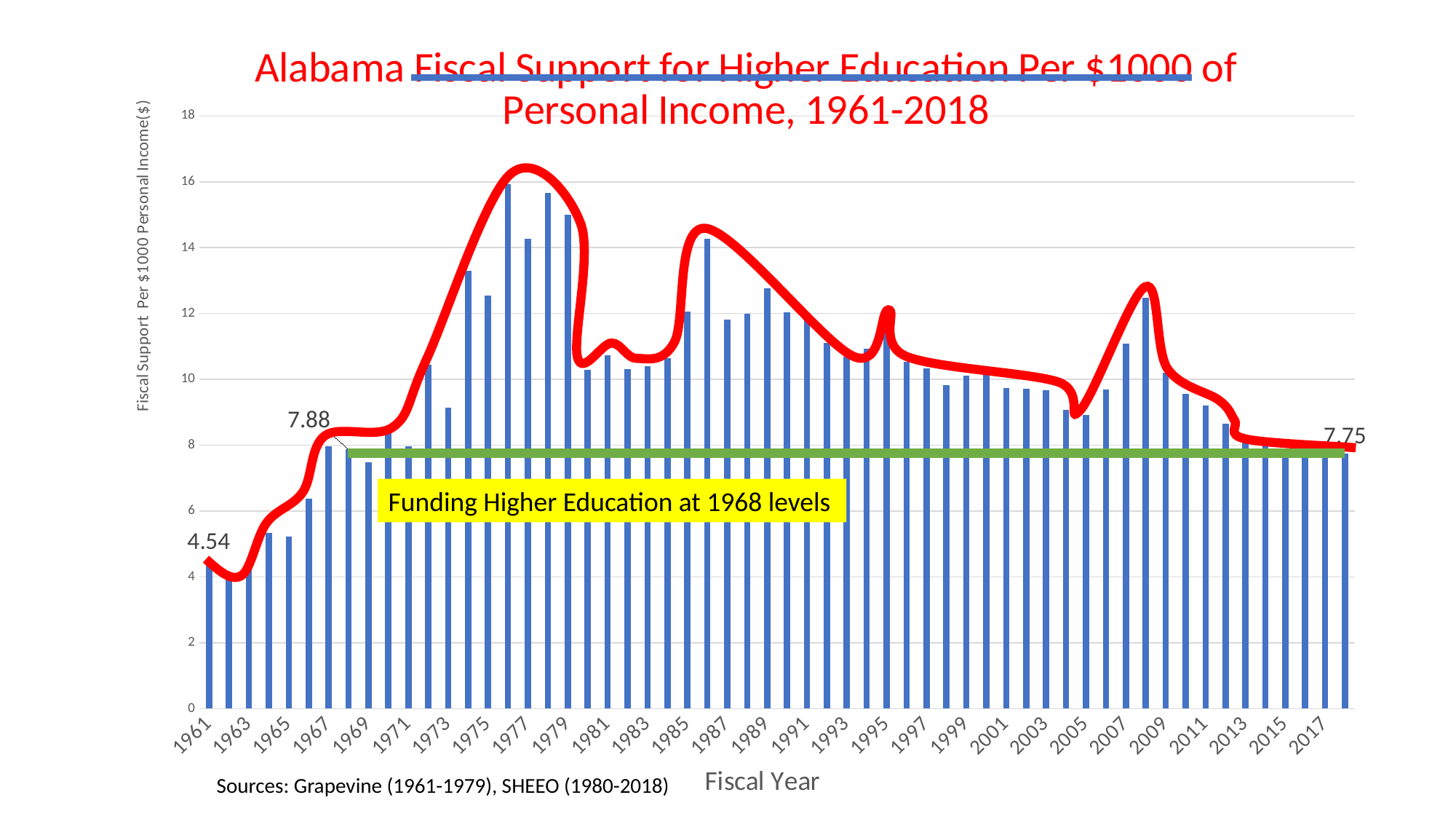
What value is labelled at the right end of the chart, for the final year 2018? 7.75 Do the values rise or fall from 1977 to 1980? fall Is the value for 1977 greater or less than 14? greater Which is larger, the value for 1968 or the value for 2018? 1968 What kind of chart is shown on the slide? bar chart Which fiscal year has the highest bar? 1976 What is the value for 1968? 7.88 What is the value for 1961? 4.54 What is the difference between the 1968 value and the 2018 value? 0.13 Is the value for 1973 greater or less than 12? less What is the difference between the 1968 value and the 1961 value? 3.34 What is the title of the x axis? Fiscal Year